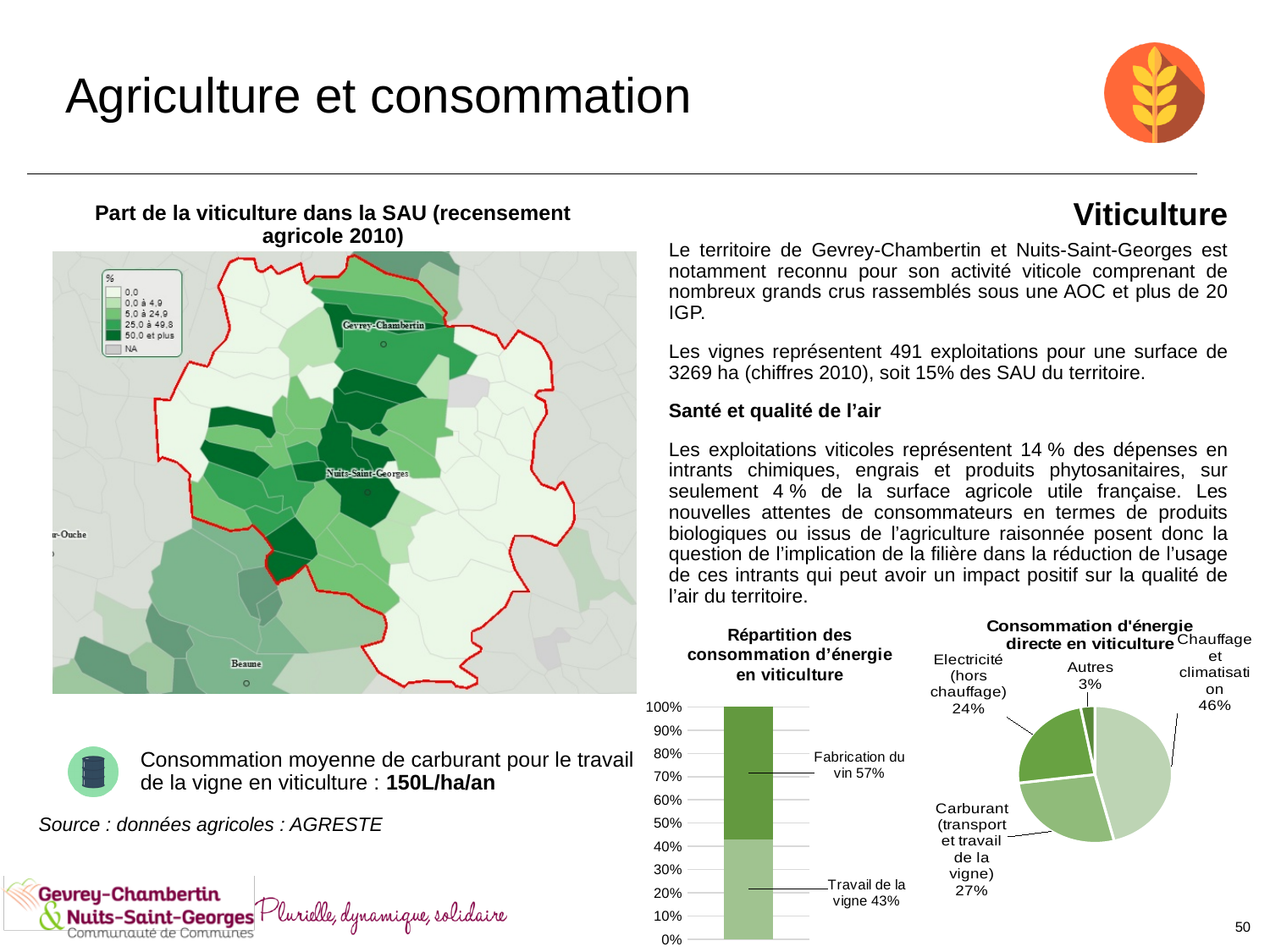
In the chart 'Répartition des consommation d'énergie en viticulture', what share is attributed to Travail de la vigne? 43% In the chart 'Répartition des consommation d'énergie en viticulture', which segment is larger, Fabrication du vin or Travail de la vigne? Fabrication du vin In the chart 'Répartition des consommation d'énergie en viticulture', what share is attributed to Fabrication du vin? 57% What kind of chart is 'Répartition des consommation d'énergie en viticulture'? Stacked bar chart In the chart 'Répartition des consommation d'énergie en viticulture', what is the difference between the Fabrication du vin and Travail de la vigne shares? 14% In the pie chart 'Consommation d'énergie directe en viticulture', what share is Electricité (hors chauffage)? 24% In the pie chart 'Consommation d'énergie directe en viticulture', what is the difference between the Carburant share and the Electricité (hors chauffage) share? 3% In the pie chart 'Consommation d'énergie directe en viticulture', which category has the largest share? Chauffage et climatisation In the pie chart 'Consommation d'énergie directe en viticulture', what share is Carburant (transport et travail de la vigne)? 27% In the pie chart 'Consommation d'énergie directe en viticulture', which category has the smallest share? Autres In the pie chart 'Consommation d'énergie directe en viticulture', what share is Chauffage et climatisation? 46% How many slices does the pie chart 'Consommation d'énergie directe en viticulture' have? 4